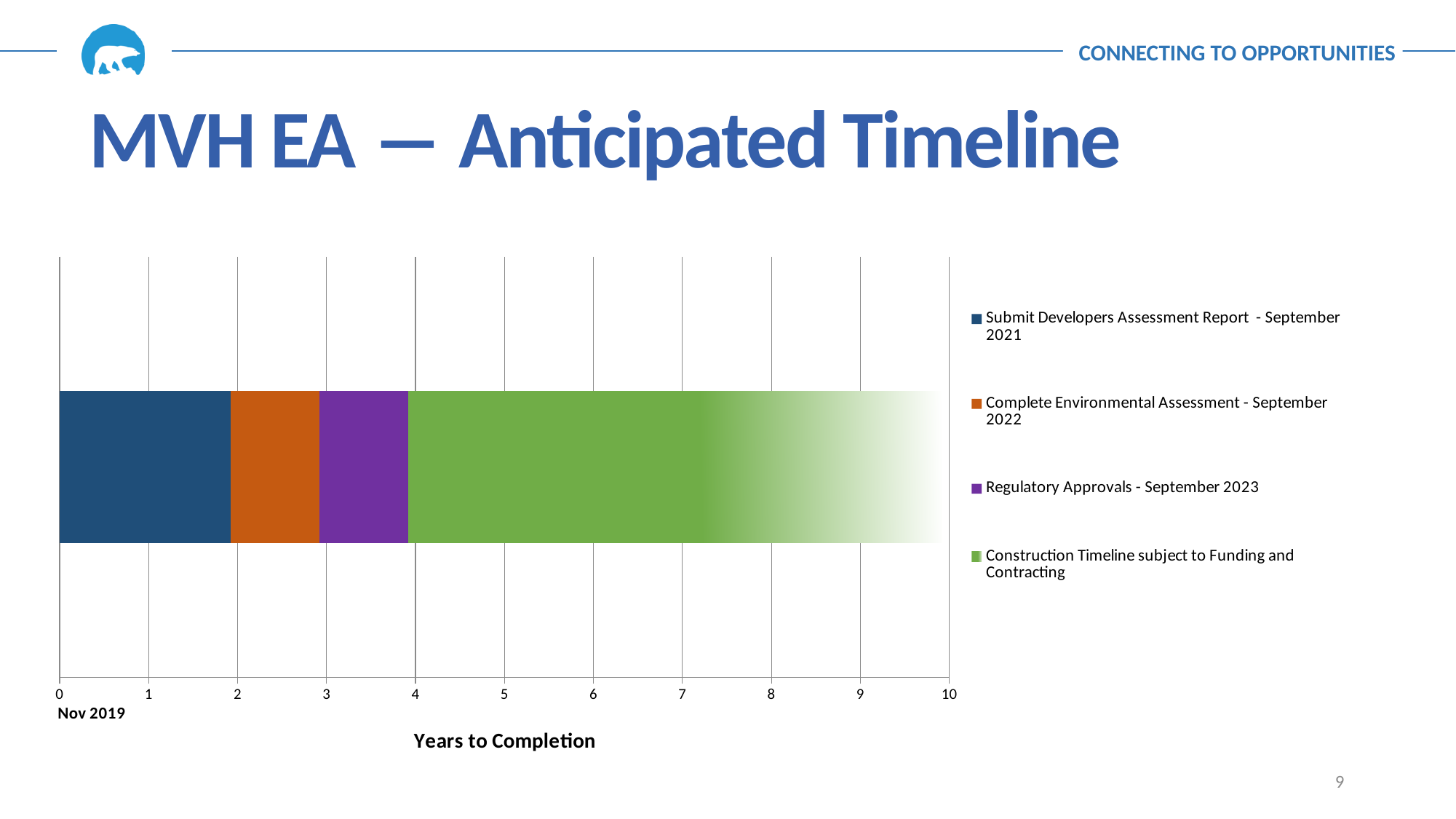
What is the title of the horizontal axis? Years to Completion Which segment is longer: Construction Timeline subject to Funding and Contracting or Regulatory Approvals - September 2023? Construction Timeline subject to Funding and Contracting Does the Submit Developers Assessment Report - September 2021 segment end at a value greater or less than 3 on the axis? less Is the length of the Submit Developers Assessment Report - September 2021 segment greater or less than 1 year? greater Which legend series occupies the longest segment of the bar? Construction Timeline subject to Funding and Contracting Does the Regulatory Approvals - September 2023 segment end at a value greater or less than 5 on the axis? less How many series does the legend list? 4 How many bars are plotted in the chart? 1 What date label is shown beneath the 0 point of the axis? Nov 2019 Which segment is longer: Submit Developers Assessment Report - September 2021 or Complete Environmental Assessment - September 2022? Submit Developers Assessment Report - September 2021 What kind of chart is shown on the slide? Stacked bar chart